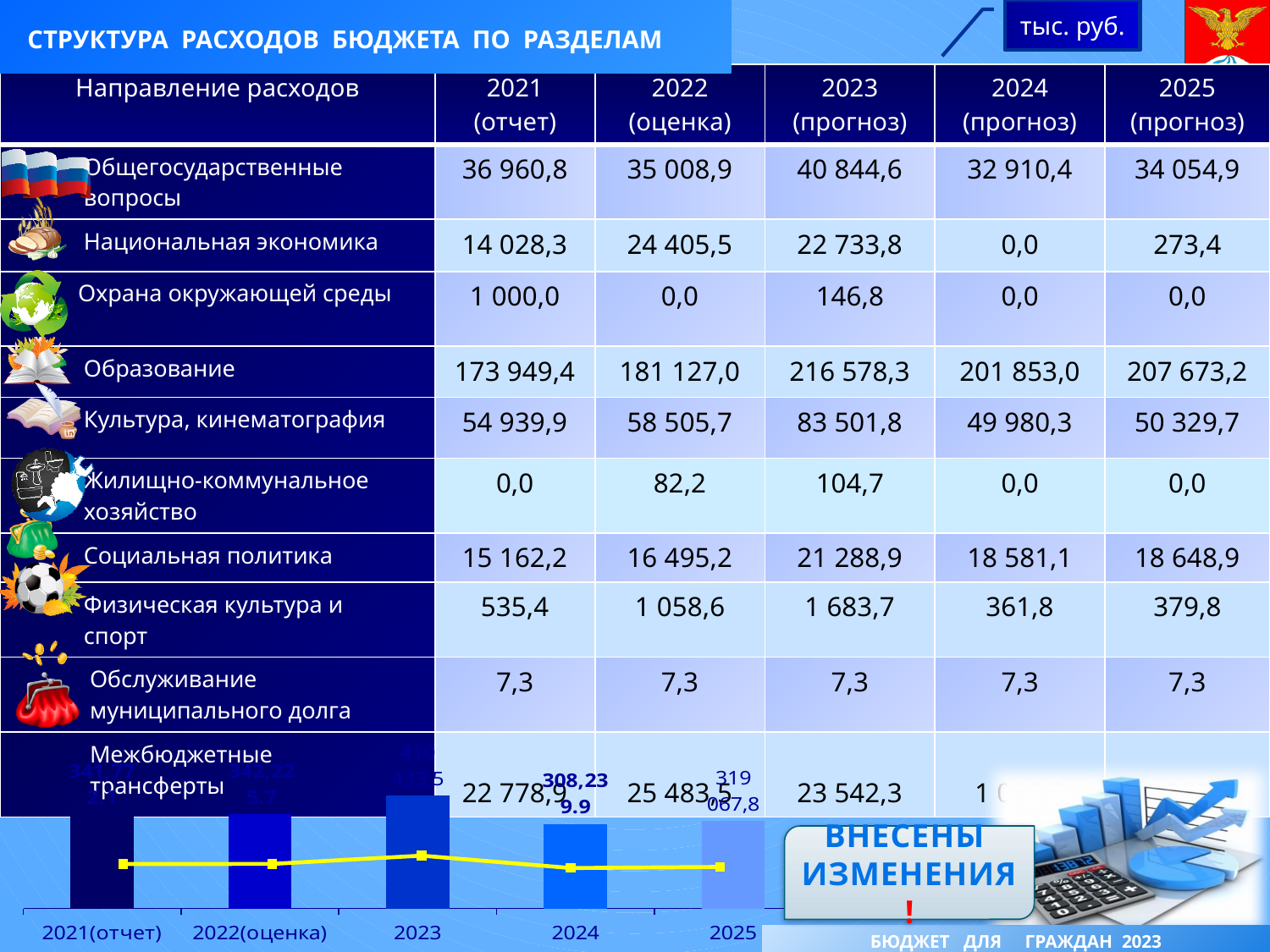
In the chart at the bottom of the slide, which category has the tallest bar? 2023 In the chart at the bottom of the slide, is the bar for 2023 taller or shorter than the bar for 2024? taller What is the label of the first category on the x axis of the chart at the bottom of the slide? 2021(отчет) What is the label of the second category on the x axis of the chart at the bottom of the slide? 2022(оценка) What kind of chart is shown at the bottom of the slide? bar chart with a line How many categories are shown on the x axis of the chart at the bottom of the slide? 5